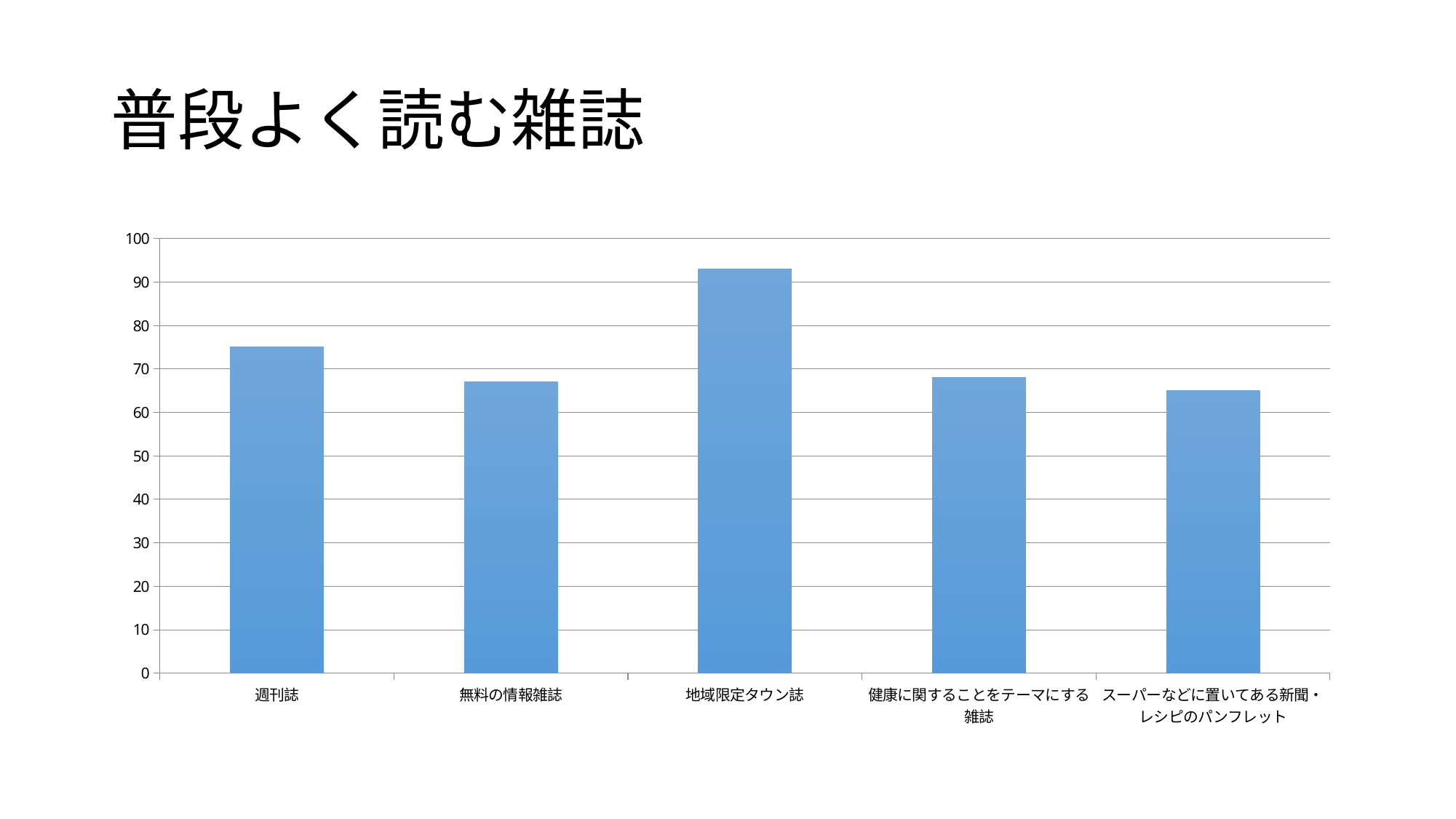
Is the value for 週刊誌 greater or less than 70? greater Is the value for スーパーなどに置いてある新聞・レシピのパンフレット greater or less than 60? greater What kind of chart is shown on the slide? bar chart Is the value for 健康に関することをテーマにする雑誌 greater or less than 80? less Which category has the highest value? 地域限定タウン誌 Which is larger, the value for 地域限定タウン誌 or the value for 健康に関することをテーマにする雑誌? 地域限定タウン誌 What is the title of the slide? 普段よく読む雑誌 How many categories are shown on the x axis? 5 What is the maximum value shown on the y axis? 100 Which is larger, the value for 週刊誌 or the value for 無料の情報雑誌? 週刊誌